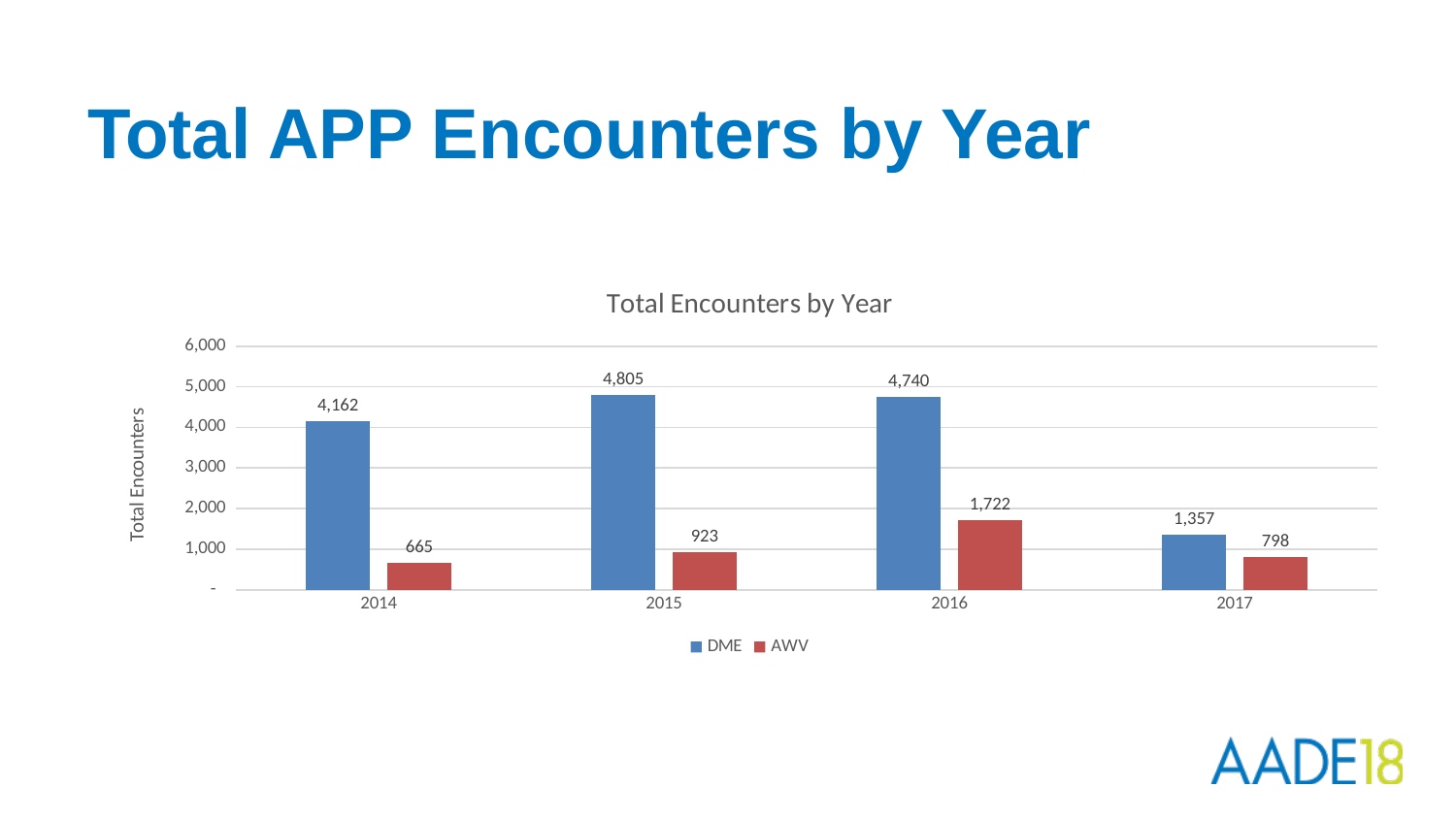
What is the difference between the DME and AWV values in 2014? 3,497 Which year has the lowest AWV value? 2014 What kind of chart is shown? bar chart What is the DME value for 2015? 4,805 Which year has the highest DME value? 2015 What is the title of the chart? Total Encounters by Year What is the DME value for 2017? 1,357 Which is larger, the AWV value for 2015 or the AWV value for 2017? 2015 How many years are shown on the x axis? 4 How many series does the legend list? 2 Is the DME value for 2016 greater or less than 4,000? greater What is the AWV value for 2016? 1,722